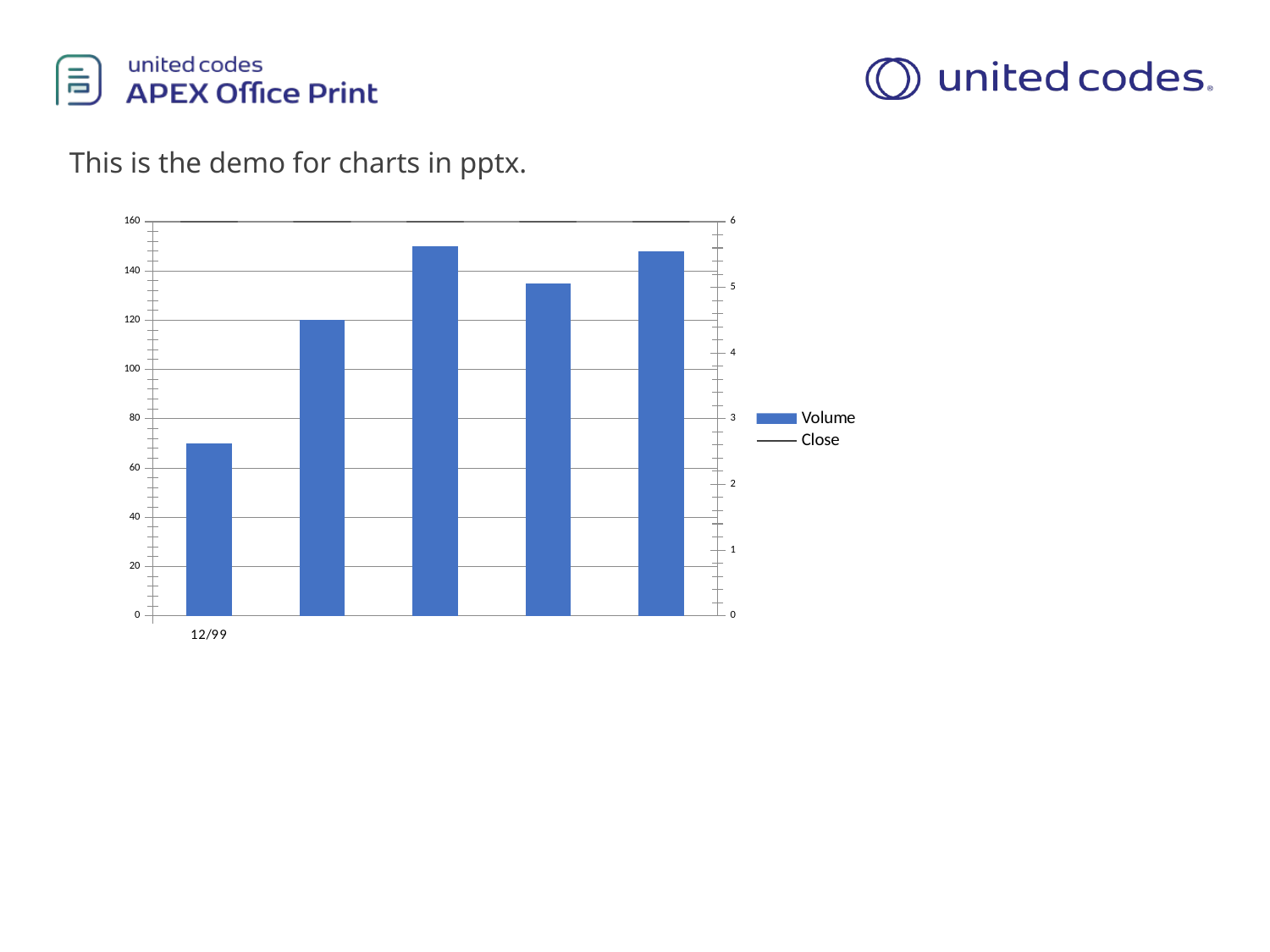
Is the Volume value of the fourth bar from the left greater or less than 120? greater What are the two entries in the chart legend? Volume and Close Does the Volume value rise or fall from the first bar to the second bar? rise What kind of chart is used for the Volume series? bar chart Is the Volume value of the third bar from the left greater or less than 140? greater What is the Volume value of the second bar from the left? 120 Which bar has the lowest Volume value? 12/99 (the first bar) How many bars are plotted in the chart? 5 Which is larger, the Volume of the second bar or the Volume of the fourth bar? the fourth bar Is the Volume value for 12/99 greater or less than 80? less How many series does the legend list? 2 What is the highest value shown on the left vertical axis? 160